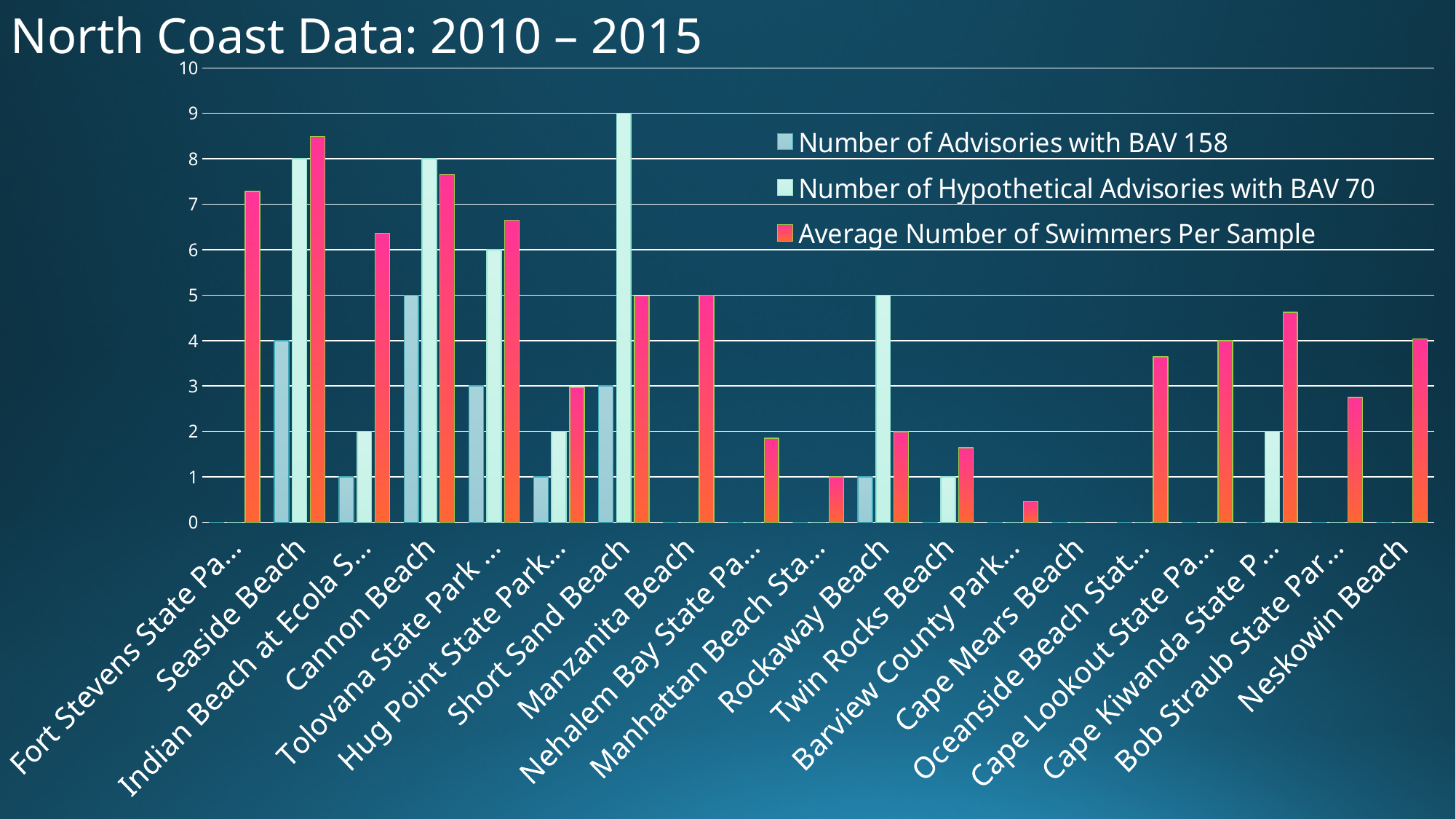
Is the Average Number of Swimmers Per Sample for Fort Stevens State Park greater or less than 7? greater What is the Number of Advisories with BAV 158 for Cannon Beach? 5 How many series does the legend list? 3 How many beaches are shown along the x axis? 19 What is the difference between the Number of Hypothetical Advisories with BAV 70 for Short Sand Beach and for Rockaway Beach? 4 What kind of chart is shown on the slide? bar chart What is the Number of Hypothetical Advisories with BAV 70 for Short Sand Beach? 9 What is the title of the chart? North Coast Data: 2010 – 2015 Is the Average Number of Swimmers Per Sample for Barview County Park greater or less than 1? less Which beach has the highest Number of Hypothetical Advisories with BAV 70? Short Sand Beach Which beach has the highest Number of Advisories with BAV 158? Cannon Beach What is the Number of Hypothetical Advisories with BAV 70 for Rockaway Beach? 5